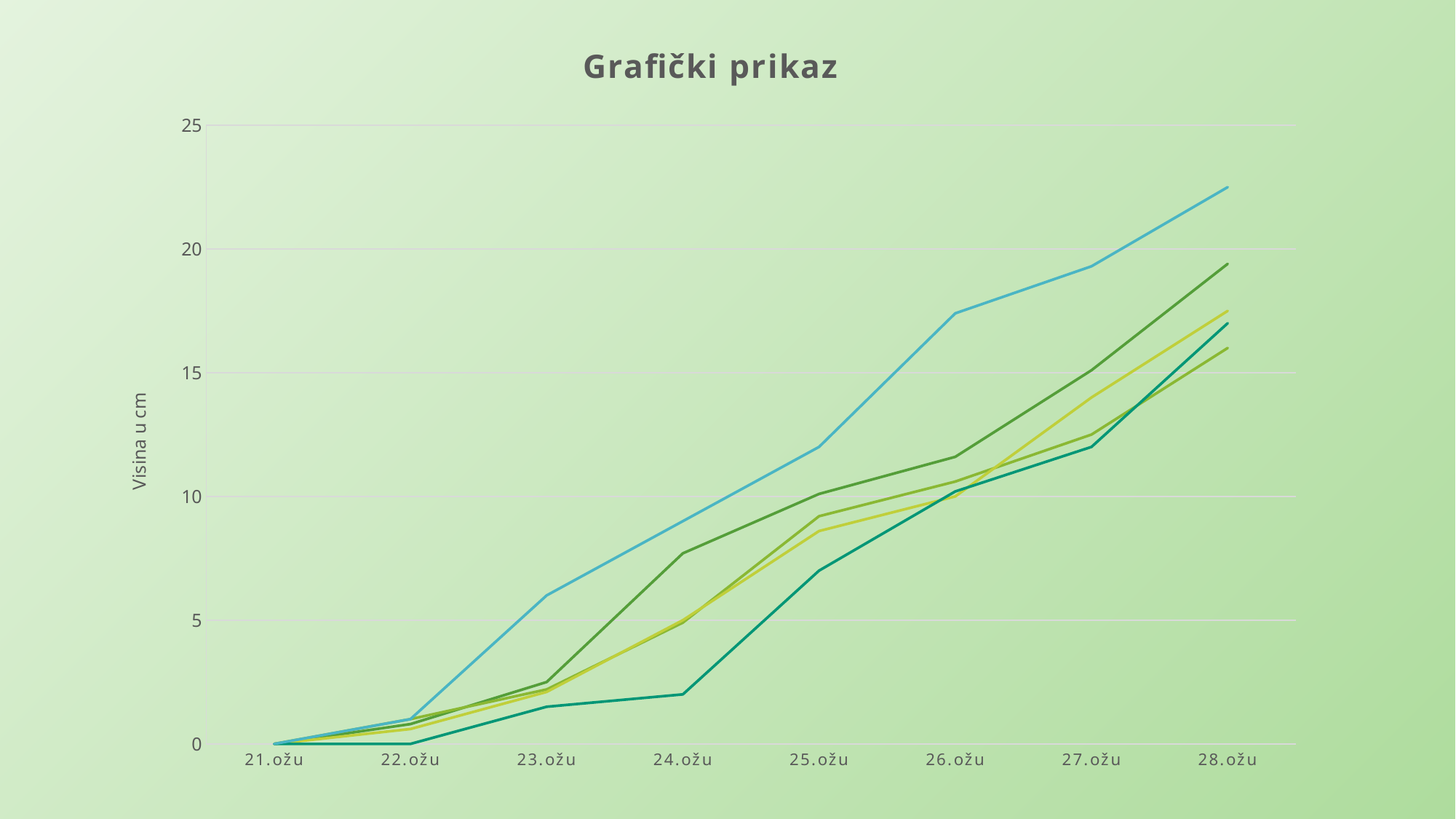
Which line has the highest value at 28.ožu? the light blue line Is the value of the light blue line at 28.ožu greater or less than 20? greater Do the lines generally rise or fall from 21.ožu to 28.ožu? rise Which line has the lowest value at 24.ožu? the teal (darkest green) line How many lines are plotted on the chart? 5 Is the value of the teal (darkest green) line at 24.ožu greater or less than 5? less What is the value of the light blue line at 21.ožu? 0 What is the title of the chart? Grafički prikaz Is the value of the light blue line at 26.ožu greater or less than 15? greater What type of chart is shown on the slide? line chart How many dates are shown along the x axis? 8 What is the label of the vertical axis? Visina u cm